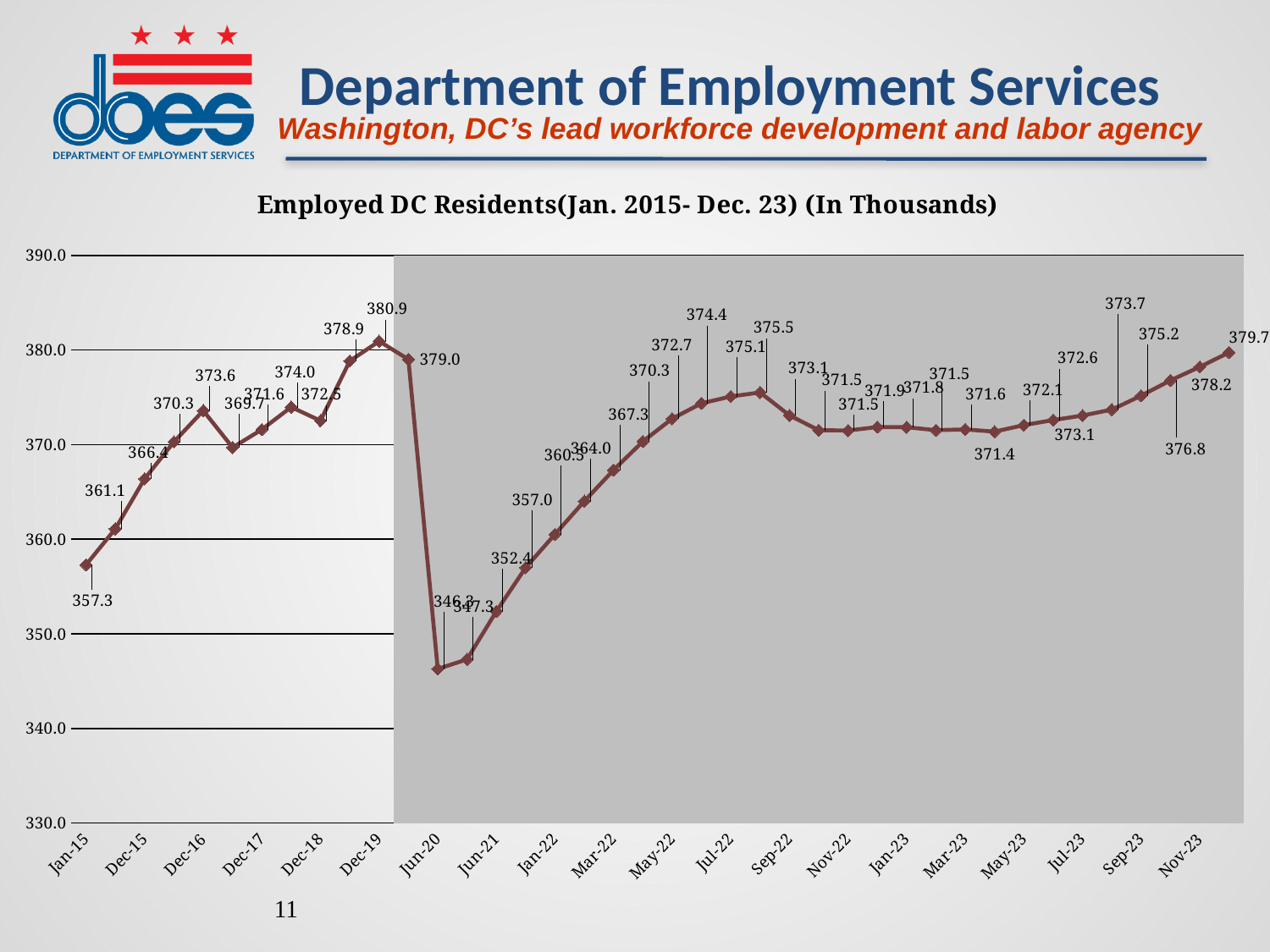
What is the lowest value plotted on the chart? 346.3 What is the value for Jan-15, the first point on the chart? 357.3 What is the title of the chart? Employed DC Residents(Jan. 2015- Dec. 23) (In Thousands) What kind of chart is shown on the slide? line chart What is the value of the last point on the chart, at the far right? 379.7 Is the value at Jun-20 greater or less than 350.0? less What is the value at the peak of the chart, at Dec-19? 380.9 Between Jun-20 and Jul-22, do the values rise or fall? rise What is the difference between the highest value (380.9) and the lowest value (346.3) on the chart? 34.6 What is the highest value plotted on the chart? 380.9 Which is larger, the value at Dec-19 or the value at Jan-15? Dec-19 What is the value at the lowest point of the chart, at Jun-20? 346.3